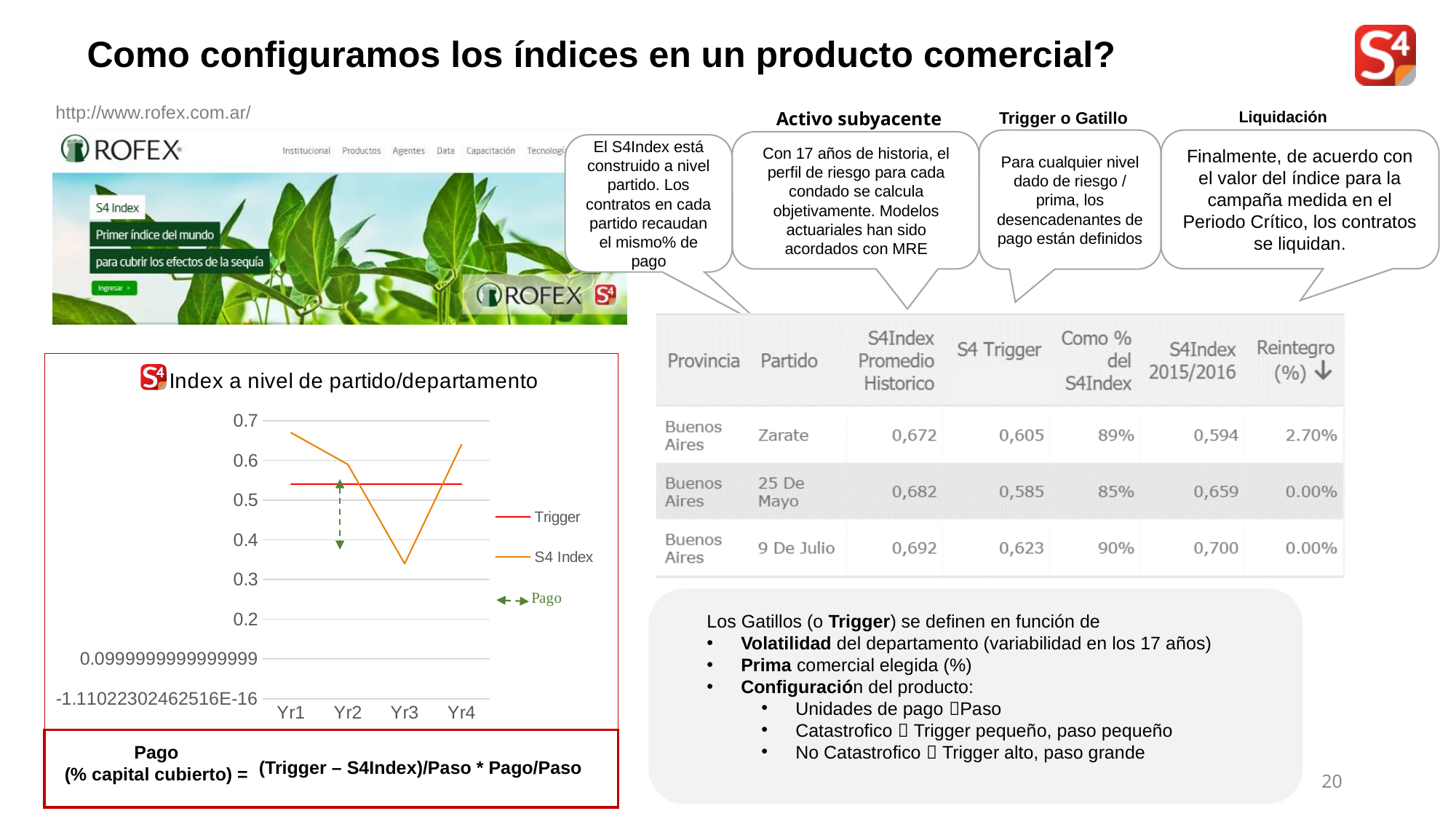
At Yr1, which is higher, the Trigger or the S4 Index? S4 Index Is the S4 Index value for Yr1 greater or less than 0.6? greater What colour is the Trigger line in the chart? red Does the S4 Index rise or fall from Yr1 to Yr3? fall How many series does the chart's legend list? 2 How many years are shown on the x axis of the chart? 4 Is the Trigger line greater or less than 0.5? greater At Yr3, which is higher, the Trigger or the S4 Index? Trigger What is the title of the chart on the slide? Index a nivel de partido/departamento In which year is the S4 Index at its lowest? Yr3 What kind of chart is shown on the slide? line chart Is the S4 Index value for Yr3 greater or less than 0.4? less